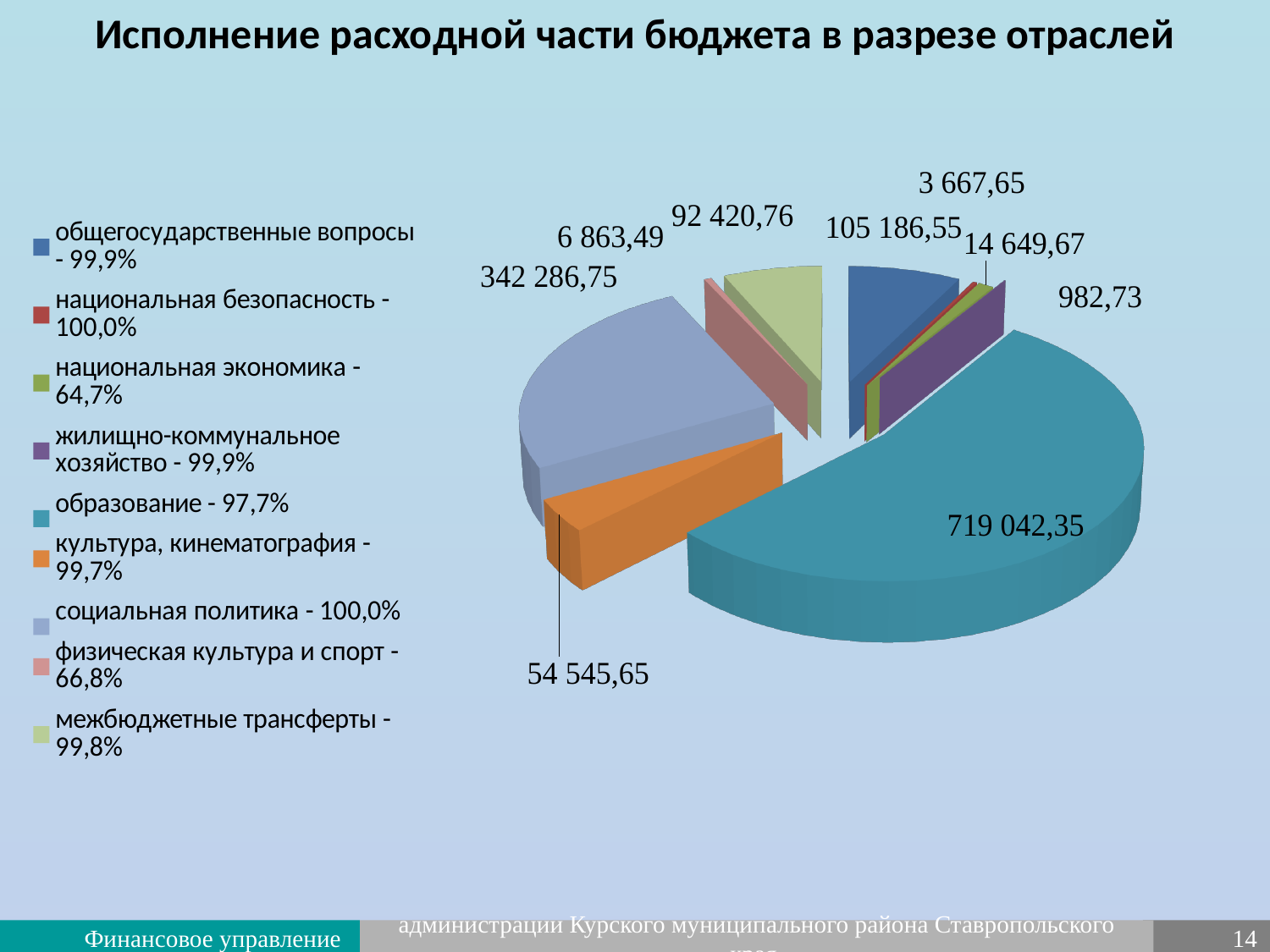
What kind of chart is shown on the slide? pie chart What is the smallest data label value shown on the pie chart? 982,73 What is the value shown for культура, кинематография? 54 545,65 How many categories does the pie chart's legend list? 9 What is the value shown for общегосударственные вопросы? 105 186,55 What is the value shown for социальная политика? 342 286,75 What is the value shown for межбюджетные трансферты? 92 420,76 What is the difference between the values for социальная политика and культура, кинематография? 287 741,10 What execution percentage does the legend give for национальная экономика? 64,7% Which is larger, the value for образование or the value for социальная политика? образование Which category has the largest slice of the pie? образование What is the value shown for образование? 719 042,35